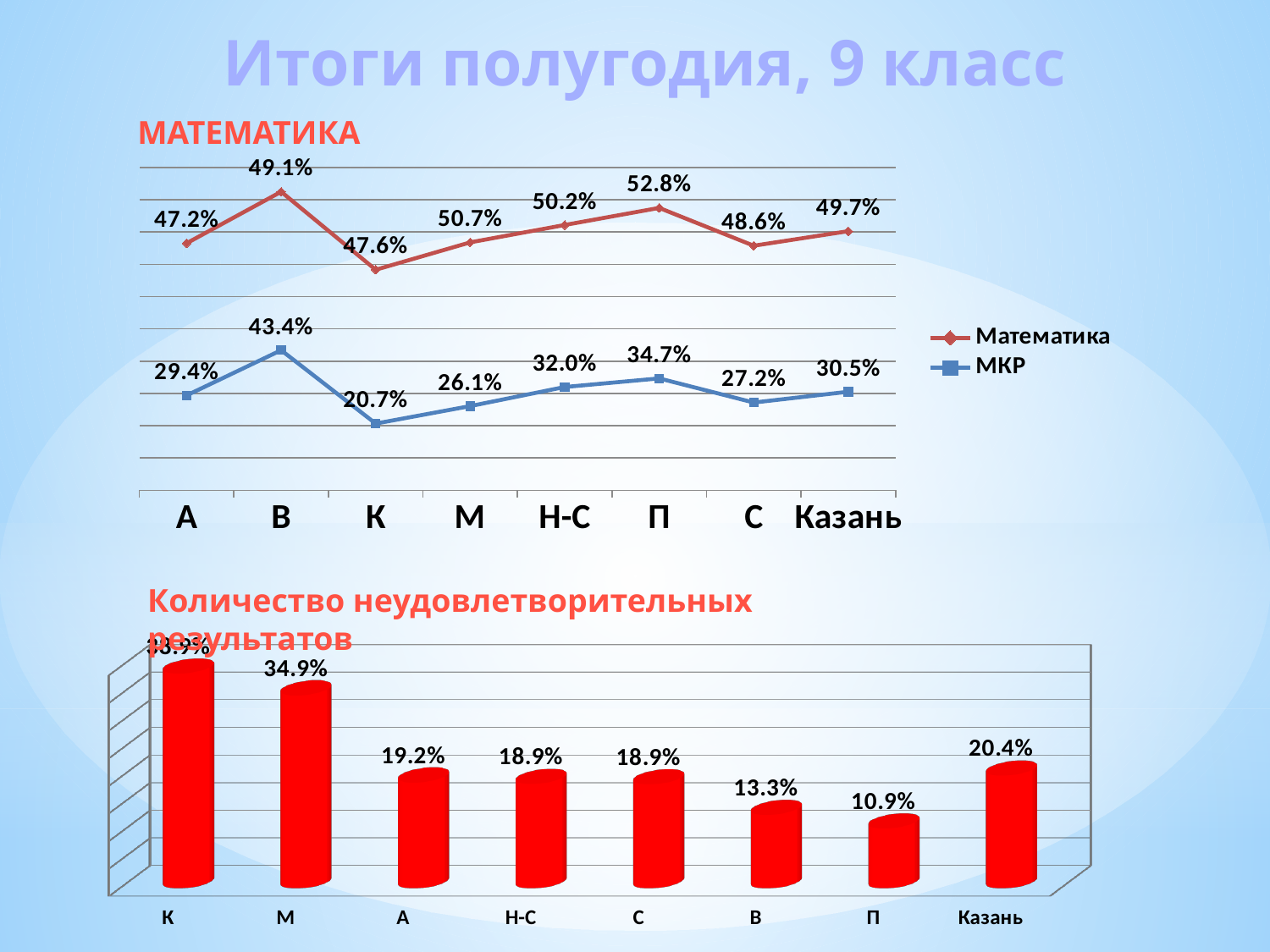
In the bottom chart (Количество неудовлетворительных результатов), what is the value for Казань? 20.4% In the top chart (МАТЕМАТИКА), which category has the lowest МКР value? К In the top chart (МАТЕМАТИКА), what is the МКР value for В? 43.4% How many series does the legend of the top chart (МАТЕМАТИКА) list? 2 In the top chart (МАТЕМАТИКА), what is the difference between the Математика and МКР values for Казань? 19.2% In the top chart (МАТЕМАТИКА), what is the Математика value for П? 52.8% What kind of chart is the bottom chart (Количество неудовлетворительных результатов)? bar chart In the bottom chart (Количество неудовлетворительных результатов), which category has the lowest value? П How many categories are shown on the x axis of the top chart (МАТЕМАТИКА)? 8 In the bottom chart (Количество неудовлетворительных результатов), which is larger, the value for М or the value for А? М In the top chart (МАТЕМАТИКА), which category has the highest Математика value? П In the bottom chart (Количество неудовлетворительных результатов), what is the difference between the values for В and П? 2.4%